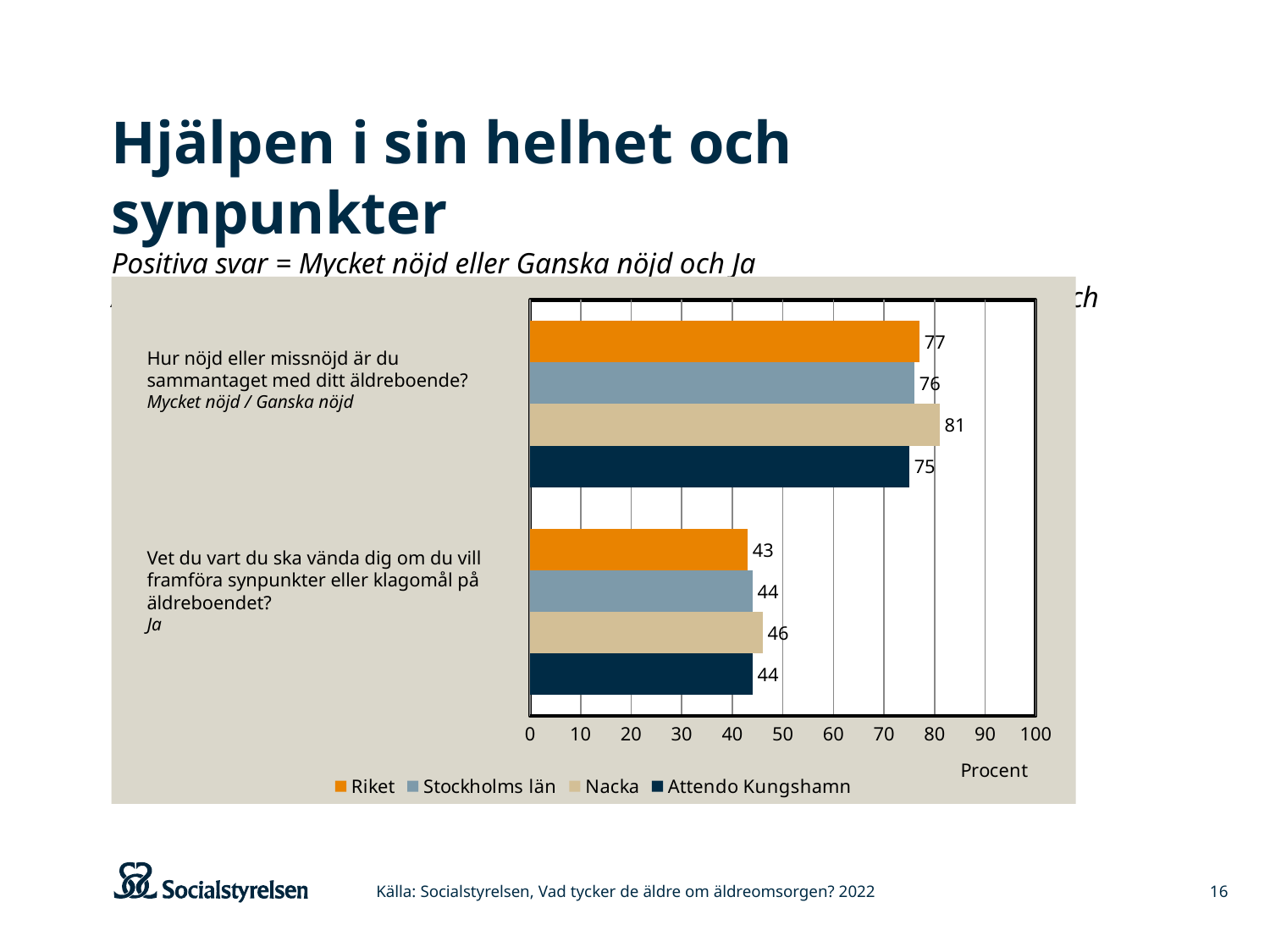
What value is shown for Nacka on the question "Hur nöjd eller missnöjd är du sammantaget med ditt äldreboende?"? 81 How many series does the legend list? 4 What kind of chart is shown on the slide? Bar chart Which is larger on the question "Vet du vart du ska vända dig om du vill framföra synpunkter eller klagomål på äldreboendet?": the value for Nacka or the value for Riket? Nacka Which series has the highest value on the question "Hur nöjd eller missnöjd är du sammantaget med ditt äldreboende?"? Nacka What is the difference between the Nacka value and the Attendo Kungshamn value on the question "Hur nöjd eller missnöjd är du sammantaget med ditt äldreboende?"? 6 How many question categories are shown on the chart? 2 What value is shown for Attendo Kungshamn on the question "Hur nöjd eller missnöjd är du sammantaget med ditt äldreboende?"? 75 What is the label on the horizontal axis of the chart? Procent Is the value for Stockholms län on the question "Hur nöjd eller missnöjd är du sammantaget med ditt äldreboende?" greater or less than 70? greater Which series has the lowest value on the question "Vet du vart du ska vända dig om du vill framföra synpunkter eller klagomål på äldreboendet?"? Riket What value is shown for Riket on the question "Vet du vart du ska vända dig om du vill framföra synpunkter eller klagomål på äldreboendet?"? 43